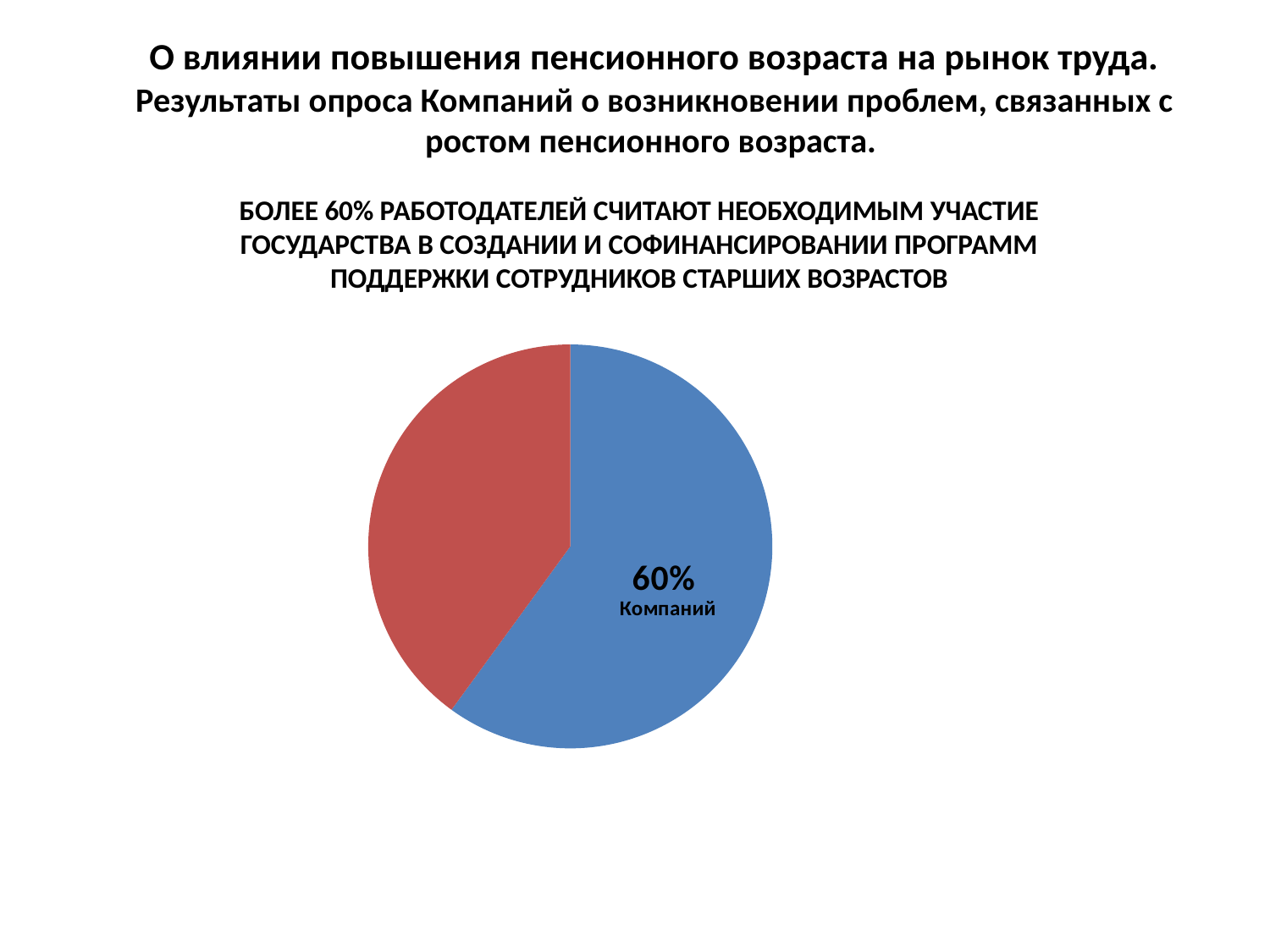
Is the share of the red slice greater or less than 50%? less Is the share of the blue slice greater or less than 50%? greater What colour is the slice labelled 60%? blue Which slice of the pie chart is larger, the blue one or the red one? the blue one What word is printed under the 60% label on the pie chart? Компаний Which slice of the pie chart is the smallest? the red slice How many slices does the pie chart have? 2 What percentage is printed on the blue slice of the pie chart? 60% What kind of chart is shown on the slide? pie chart